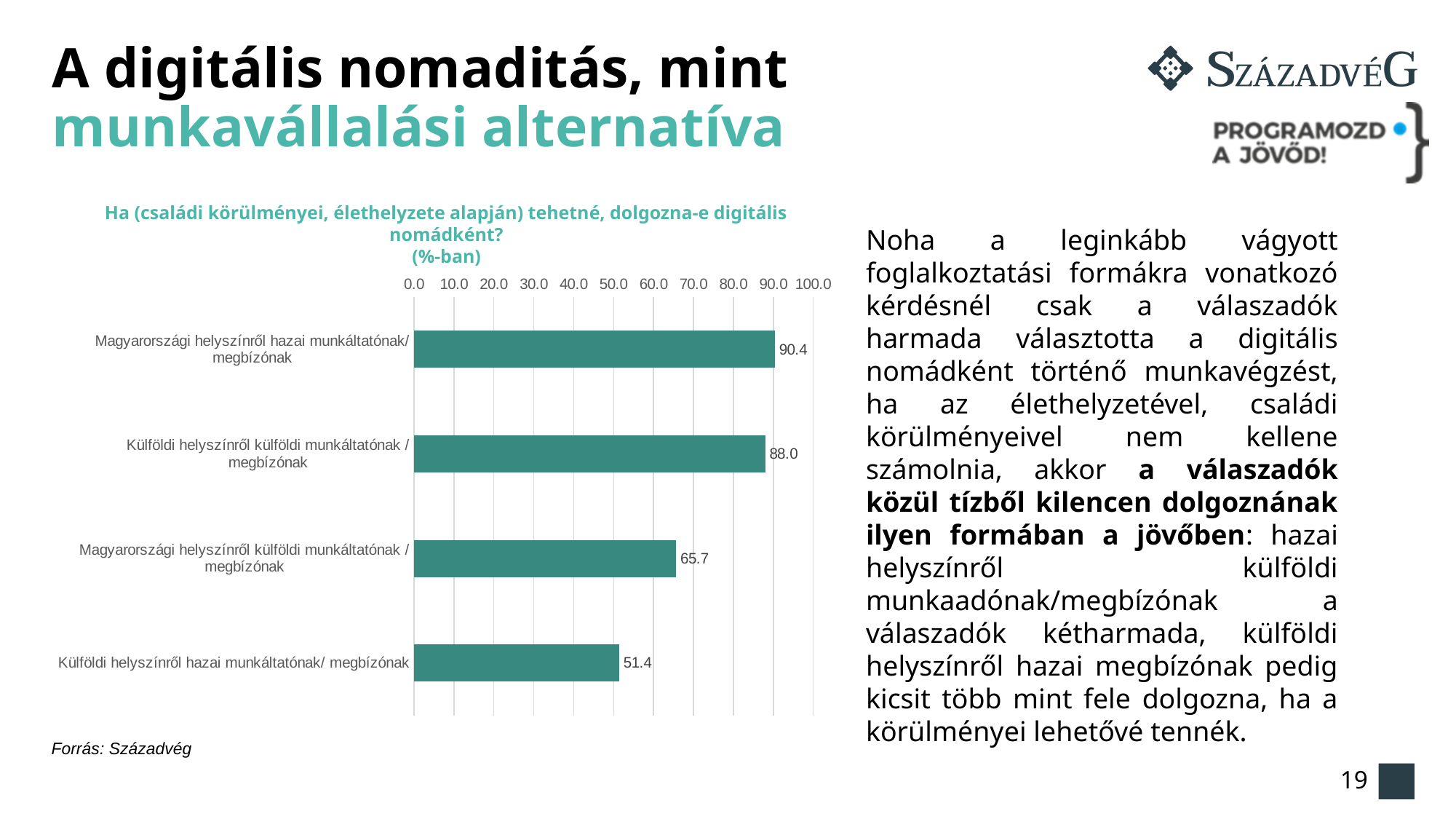
What is the value for "Külföldi helyszínről külföldi munkáltatónak / megbízónak"? 88.0 What is the difference between the values for "Magyarországi helyszínről hazai munkáltatónak/ megbízónak" and "Külföldi helyszínről hazai munkáltatónak/ megbízónak"? 39.0 What is the value for "Magyarországi helyszínről külföldi munkáltatónak / megbízónak"? 65.7 What is the value for "Magyarországi helyszínről hazai munkáltatónak/ megbízónak"? 90.4 Is the value for "Magyarországi helyszínről külföldi munkáltatónak / megbízónak" greater or less than 60.0? greater How many categories are shown in the chart? 4 What kind of chart is shown on the slide? bar chart Which is larger: the value for "Magyarországi helyszínről külföldi munkáltatónak / megbízónak" or "Külföldi helyszínről hazai munkáltatónak/ megbízónak"? Magyarországi helyszínről külföldi munkáltatónak / megbízónak Which category has the highest value? Magyarországi helyszínről hazai munkáltatónak/ megbízónak What is the source cited below the chart? Századvég Which category has the lowest value? Külföldi helyszínről hazai munkáltatónak/ megbízónak What is the value for "Külföldi helyszínről hazai munkáltatónak/ megbízónak"? 51.4